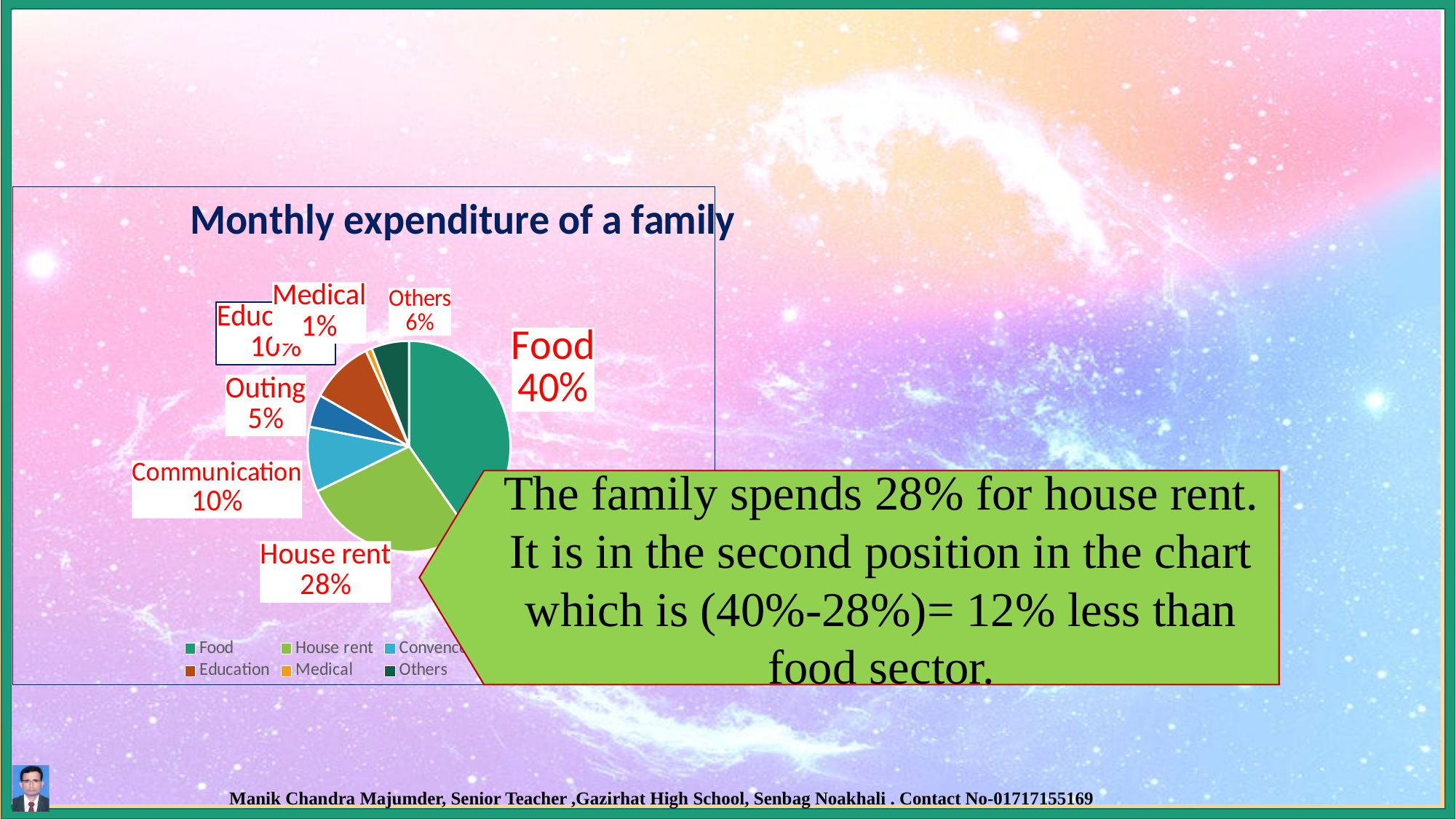
What kind of chart is shown on the slide? pie chart How many categories are shown in the pie chart? 7 What percentage of the monthly expenditure goes to Others? 6% Which category has the largest share of the monthly expenditure? Food What percentage of the monthly expenditure goes to Medical? 1% Which category has the smallest share of the monthly expenditure? Medical How much larger is the Food share than the House rent share? 12% What percentage of the monthly expenditure goes to Food? 40% Which is larger, the share for Communication or the share for Outing? Communication What is the title of the chart? Monthly expenditure of a family What percentage of the monthly expenditure goes to Outing? 5% What percentage of the monthly expenditure goes to House rent? 28%